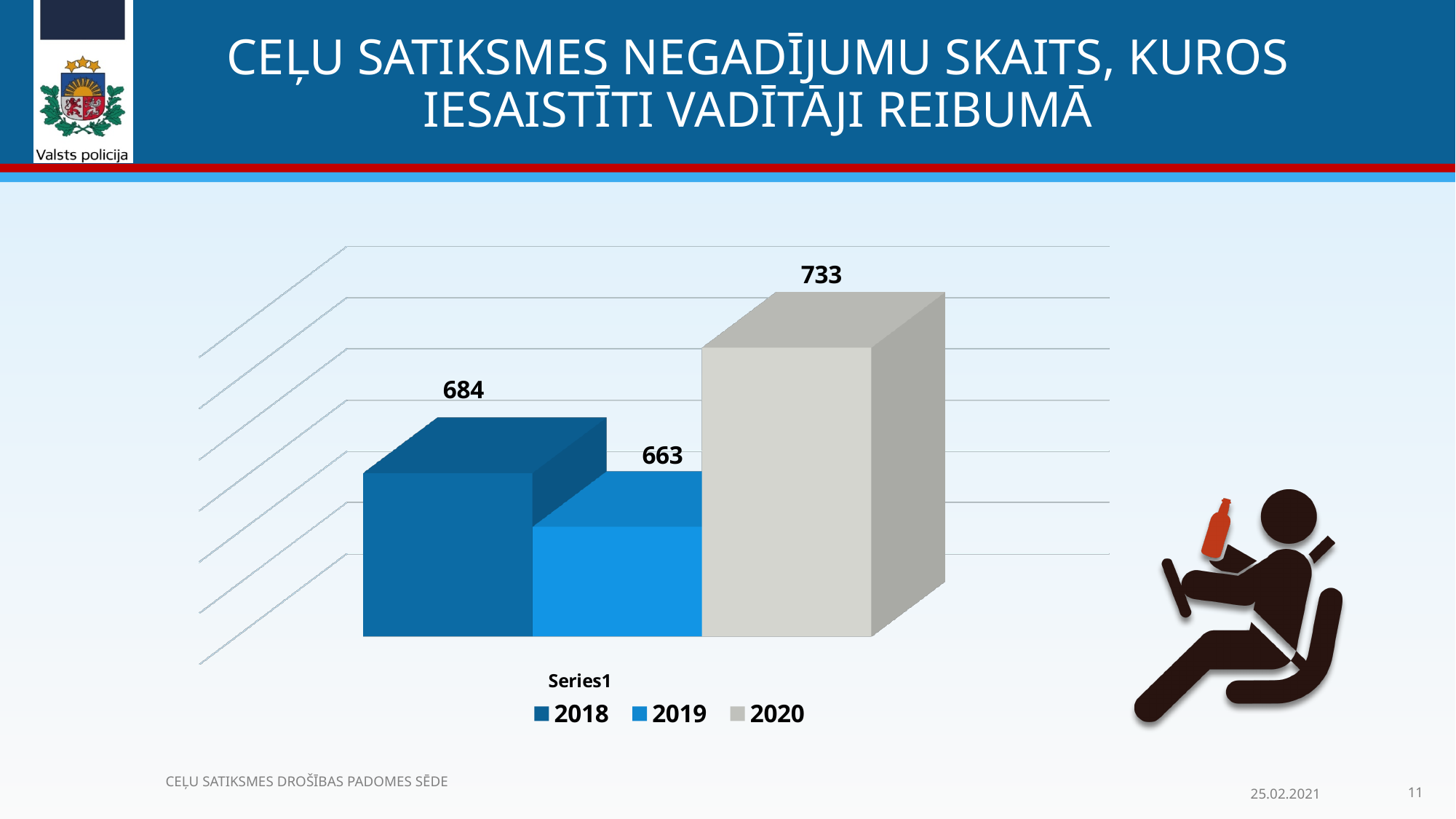
What kind of chart is shown on the slide? bar chart What is the difference between the values for 2018 and 2019? 21 What is the value for 2018? 684 Which is larger, the value for 2018 or the value for 2020? 2020 What is the difference between the values for 2020 and 2019? 70 Which year has the lowest value? 2019 What is the value for 2020? 733 Which year has the highest value? 2020 What colour is the bar for 2020? grey What is the value for 2019? 663 What is the category label shown below the bars? Series1 How many series does the legend list? 3